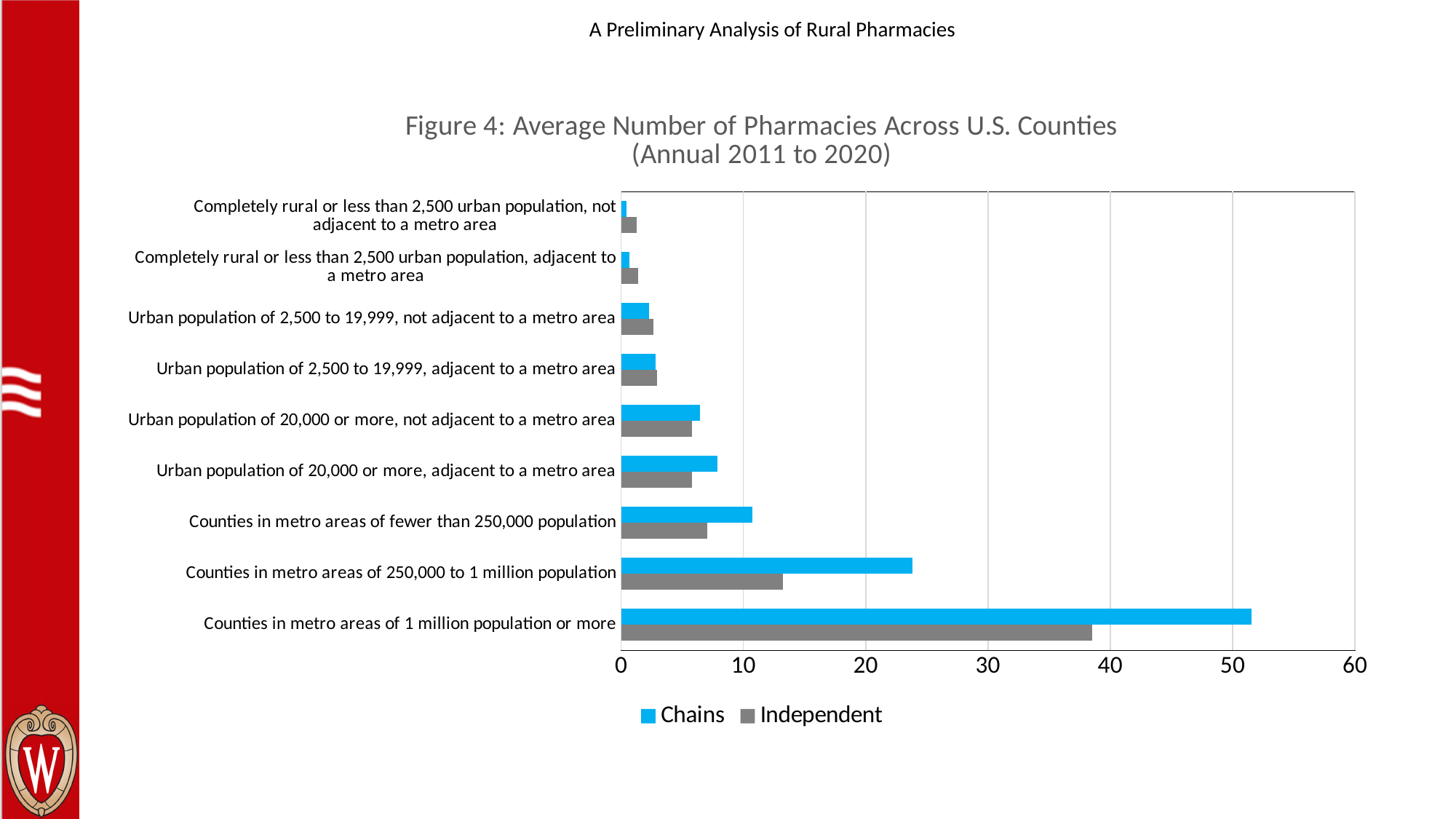
For Completely rural or less than 2,500 urban population, not adjacent to a metro area, which series has the larger value, Chains or Independent? Independent Which category has the highest value for Independent? Counties in metro areas of 1 million population or more Which series is shown in blue in the legend? Chains How many series does the legend list? 2 For Counties in metro areas of fewer than 250,000 population, which series has the larger value, Chains or Independent? Chains Is the Independent value for Counties in metro areas of 250,000 to 1 million population greater or less than 20? less Is the Chains value for Counties in metro areas of 250,000 to 1 million population greater or less than 20? greater Is the Independent value for Counties in metro areas of 1 million population or more greater or less than 30? greater Which category has the highest value for Chains? Counties in metro areas of 1 million population or more How many county categories are plotted on the chart? 9 What kind of chart is shown on the slide? bar chart